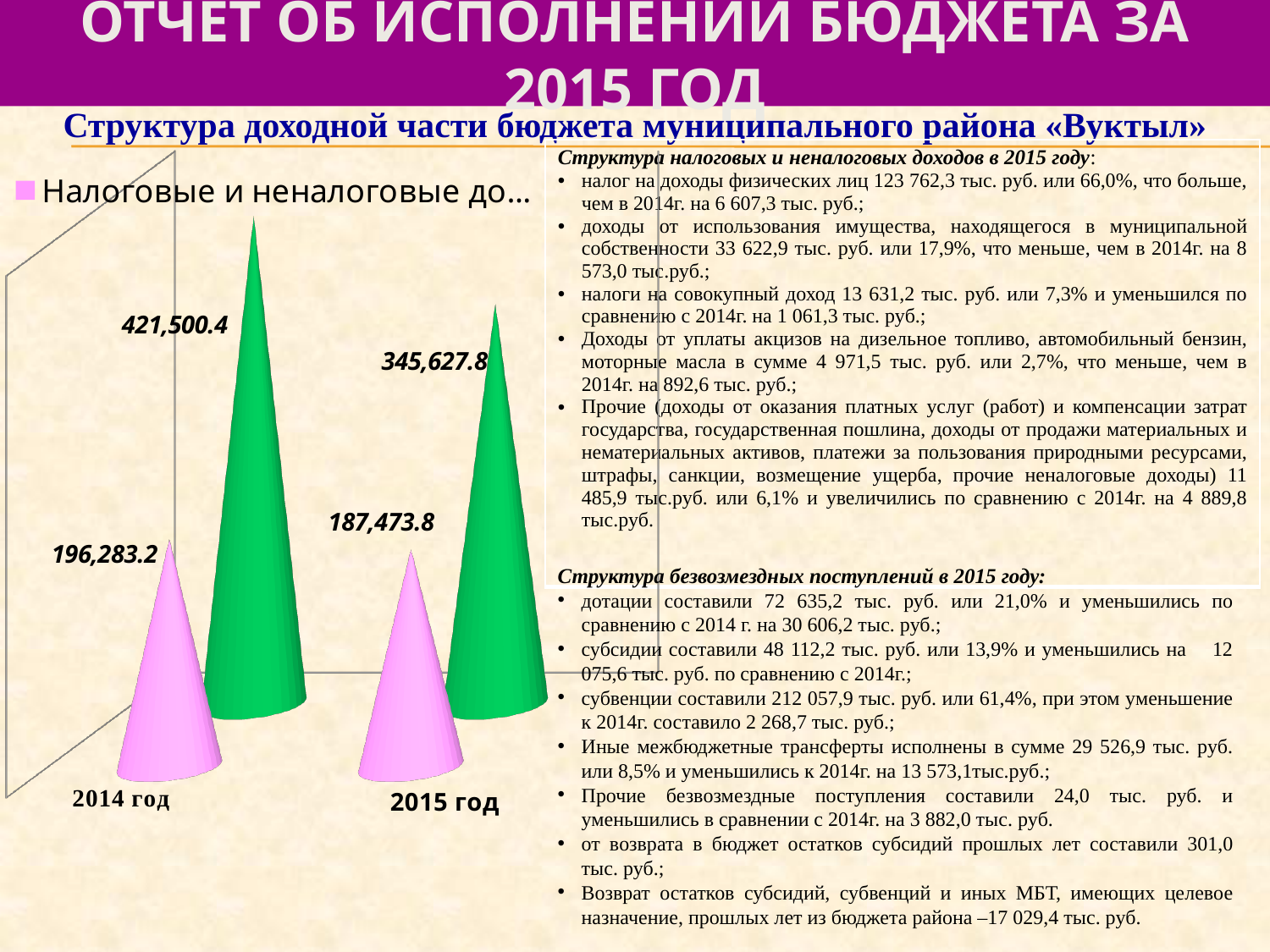
What is the value of the pink series for 2015 год? 187,473.8 Which category has the lowest value for the pink series? 2015 год Do the values of the green series rise or fall from 2014 год to 2015 год? fall By how much did the green series decrease from 2014 год to 2015 год? 75,872.6 How many categories are shown on the x axis of the chart? 2 In 2015 год, which is larger: the green series or the pink series? the green series What is the value of the green series for 2014 год? 421,500.4 What kind of chart is shown on the slide? bar chart What is the value of the pink series for 2014 год? 196,283.2 What is the value of the green series for 2015 год? 345,627.8 What is the difference between the pink series values for 2014 год and 2015 год? 8,809.4 Which category has the highest value for the green series? 2014 год